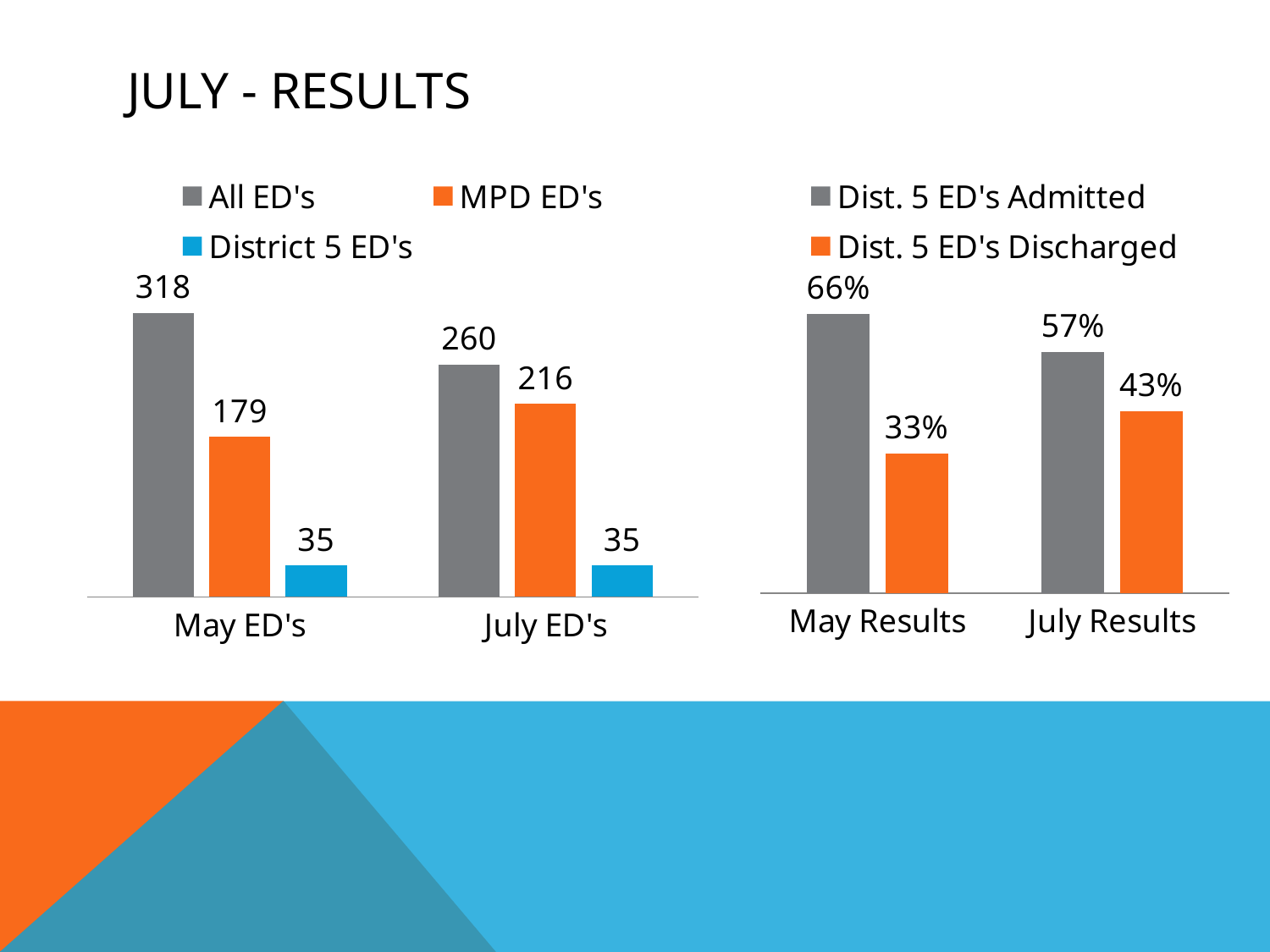
In the right chart, what is the value for Dist. 5 ED's Discharged in July Results? 43% In the left chart, which series has the lowest value in July ED's? District 5 ED's In the right chart, what is the difference between Dist. 5 ED's Admitted and Dist. 5 ED's Discharged in May Results? 33% In the left chart, what is the value for MPD ED's in July ED's? 216 In the right chart, does Dist. 5 ED's Admitted rise or fall from May Results to July Results? fall In the left chart, what is the difference between All ED's in May ED's and All ED's in July ED's? 58 What kind of chart is the right chart? bar chart In the left chart, what is the value for District 5 ED's in May ED's? 35 How many series does the legend of the left chart list? 3 In the right chart, what is the value for Dist. 5 ED's Admitted in May Results? 66% In the left chart, what is the value for All ED's in May ED's? 318 In the left chart, is MPD ED's larger in May ED's or July ED's? July ED's